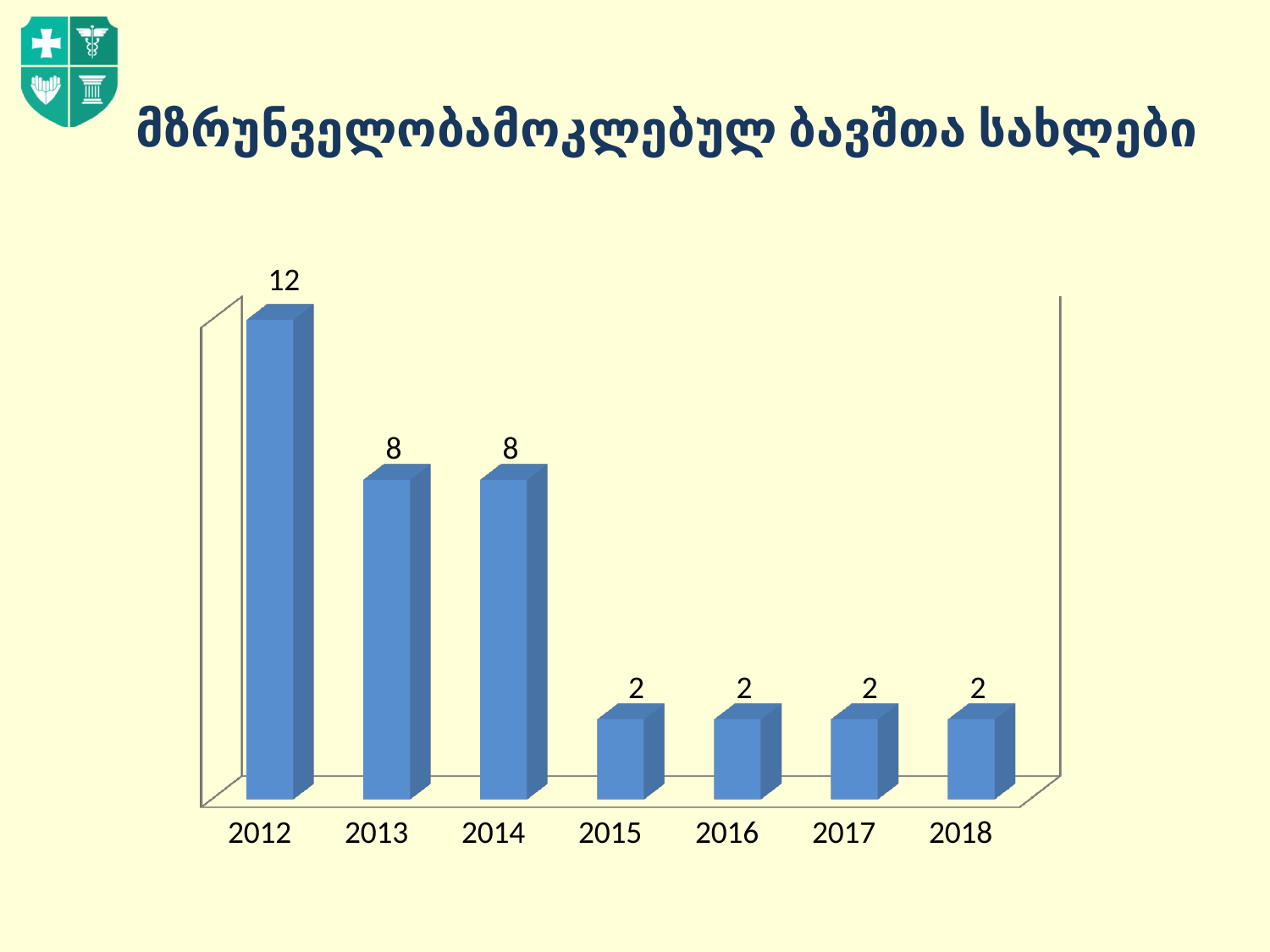
What is the value for 2014? 8 Which year has the highest value? 2012 Do the values generally rise or fall from 2012 to 2018? fall Which is larger, the value for 2013 or the value for 2016? 2013 How many years are shown on the x axis? 7 What is the value for 2017? 2 How many years have a value of 2? 4 What is the difference between the values for 2012 and 2013? 4 What is the value for 2012? 12 What colour are the bars in the chart? blue What is the difference between the values for 2014 and 2015? 6 What kind of chart is shown on the slide? bar chart